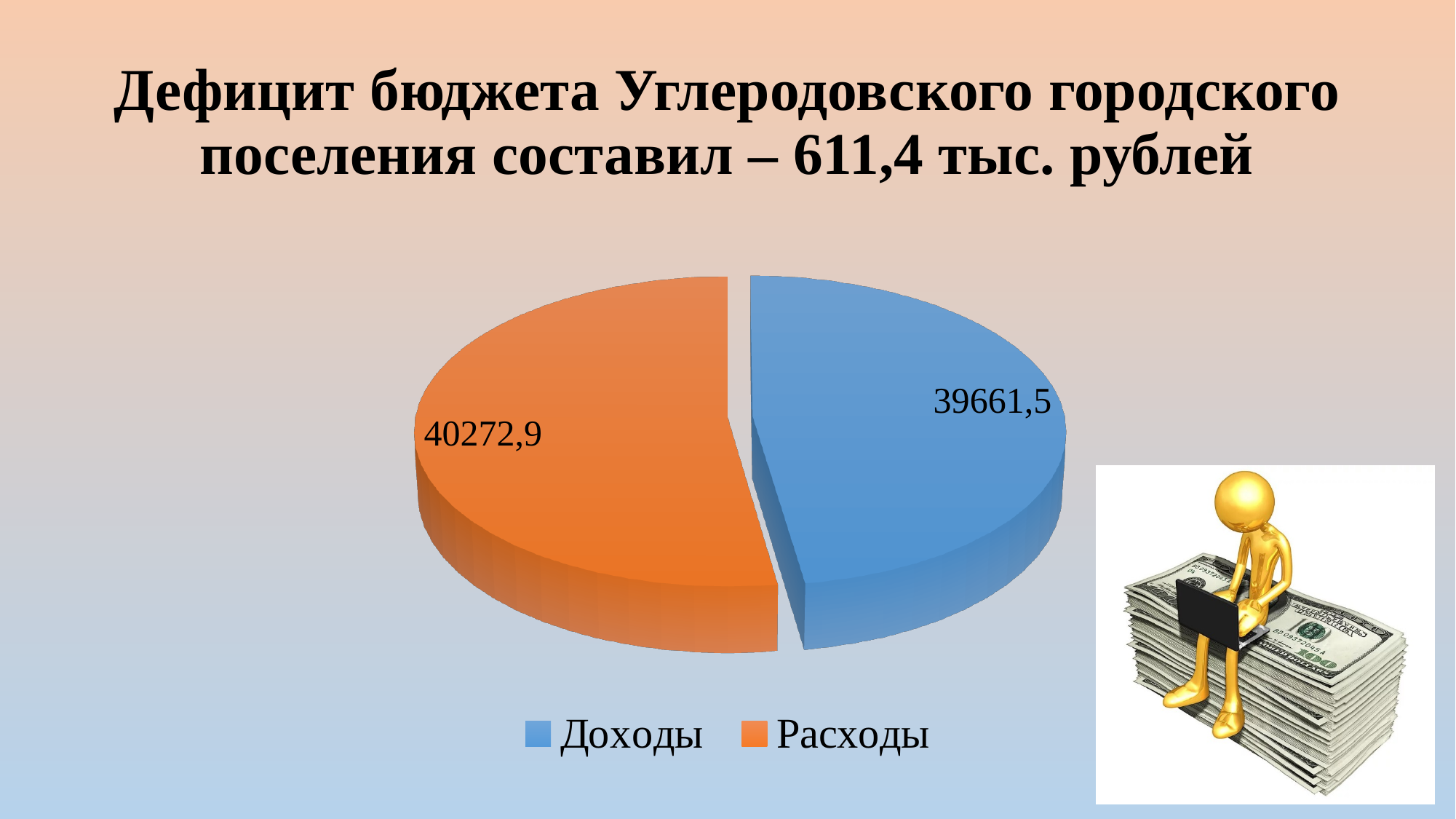
What kind of chart is shown on the slide? pie chart Which category has the largest value in the pie chart? Расходы How many slices does the pie chart have? 2 What is the value of the Доходы slice? 39661,5 What colour is the Расходы slice? orange What is the value of the Расходы slice? 40272,9 Which slice has the larger value, Доходы or Расходы? Расходы Which category has the smallest value in the pie chart? Доходы What is the total of the two slices in the pie chart? 79934,4 How many entries does the legend list? 2 What is the title of the slide above the chart? Дефицит бюджета Углеродовского городского поселения составил – 611,4 тыс. рублей What is the difference between the Расходы and Доходы values? 611,4